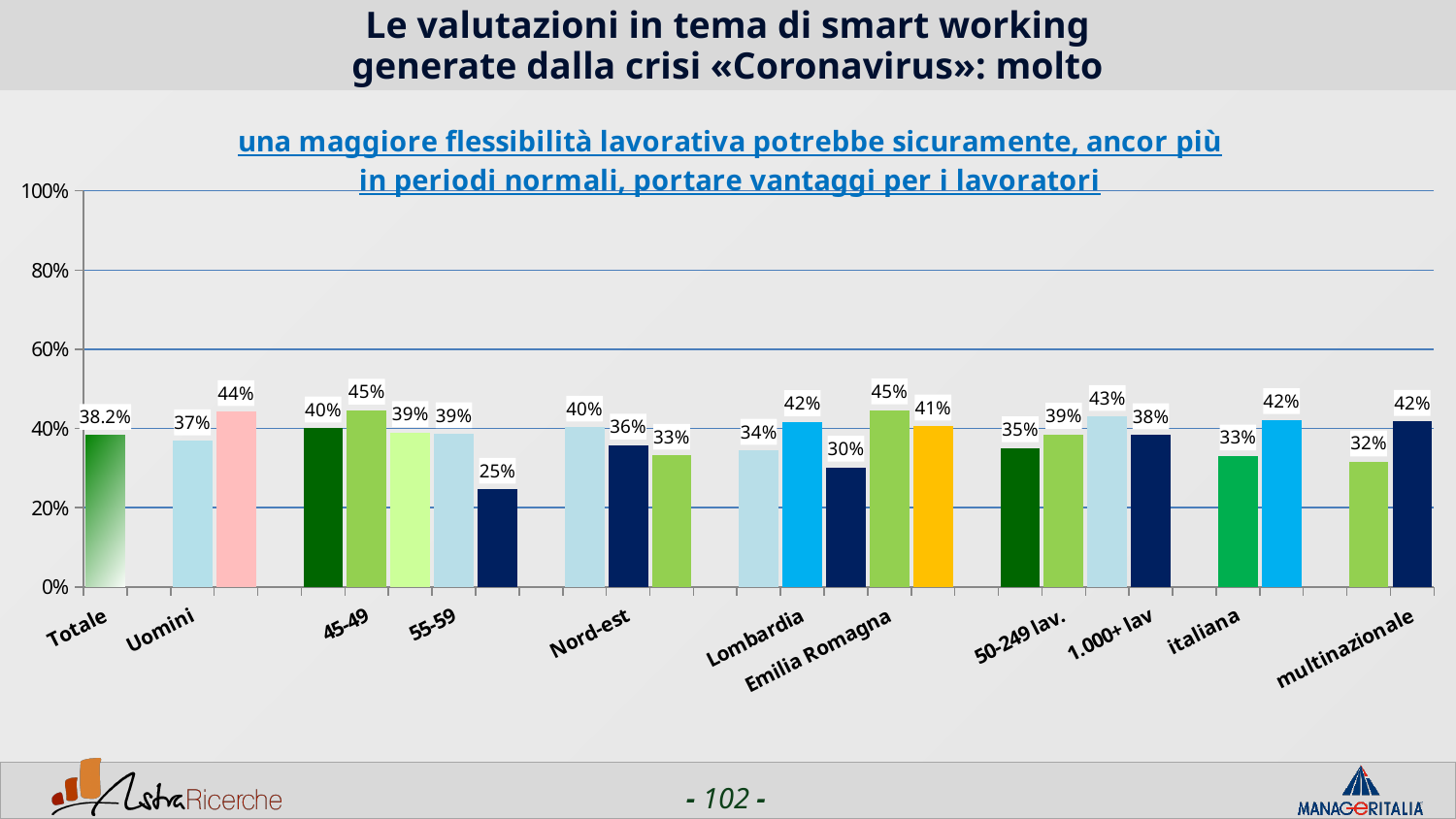
What is the difference between the values for Lombardia and Nord-est? 6 percentage points What is the value for Uomini? 37% What is the value for the 45-49 category? 45% What is the value for 1.000+ lav? 38% What is the value for Lombardia? 42% What is the value for Totale? 38.2% What is the value for Emilia Romagna? 45% What is the value for multinazionale? 42% What kind of chart is shown on the slide? Bar chart Which is larger, the value for Emilia Romagna or the value for italiana? Emilia Romagna What is the value for the 55-59 category? 39% What is the value for Nord-est? 36%